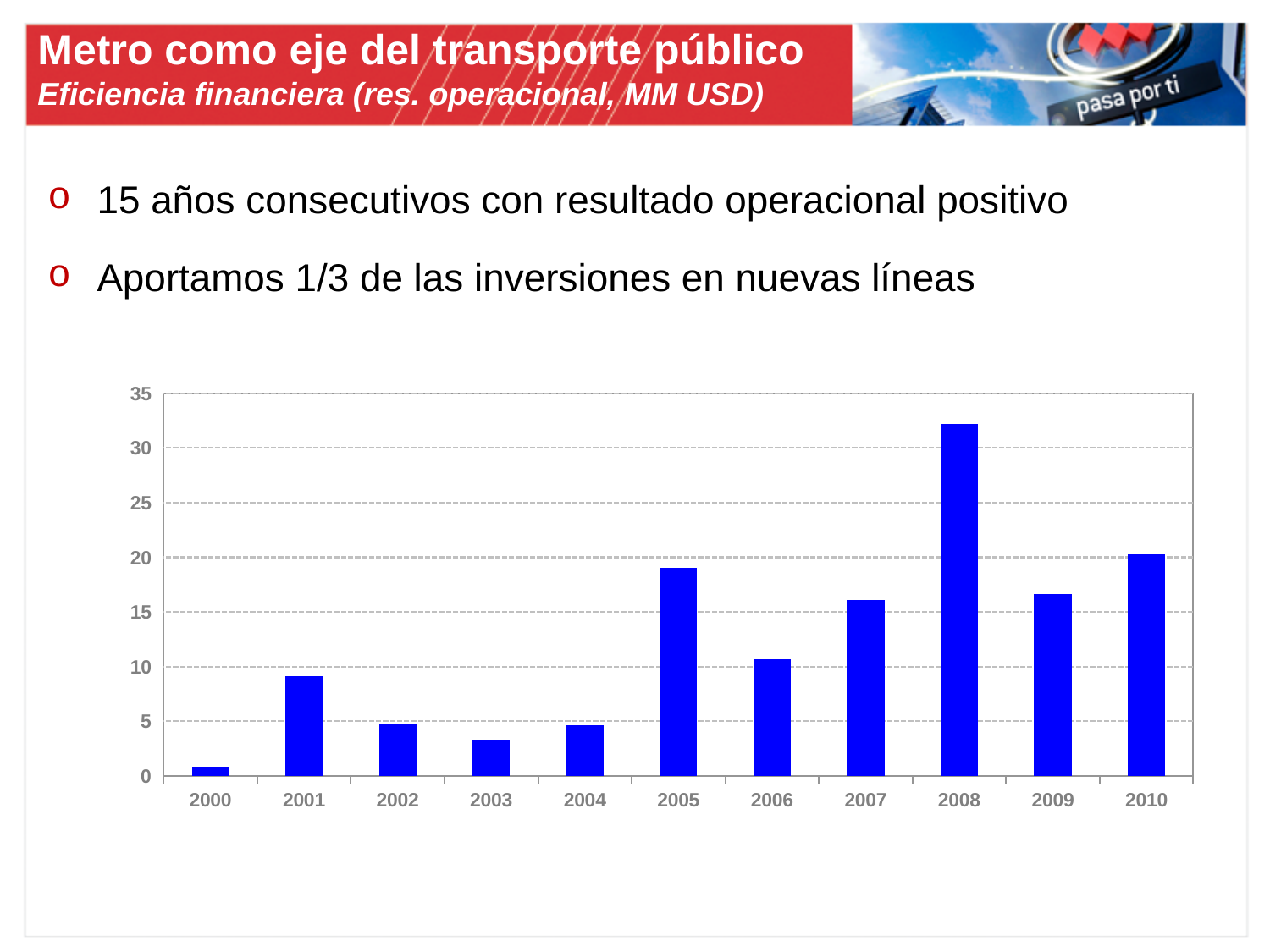
Is the value for 2008 greater or less than 30? greater Is the value for 2001 greater or less than 10? less Which is larger, the value for 2009 or the value for 2003? 2009 Which year has the lowest bar in the chart? 2000 Which year has the highest bar in the chart? 2008 Does the value rise or fall from 2008 to 2009? fall What kind of chart is shown on the slide? bar chart How many years are shown on the x axis of the chart? 11 What is the first year shown on the x axis of the chart? 2000 Is the value for 2003 greater or less than 5? less Which is larger, the value for 2005 or the value for 2006? 2005